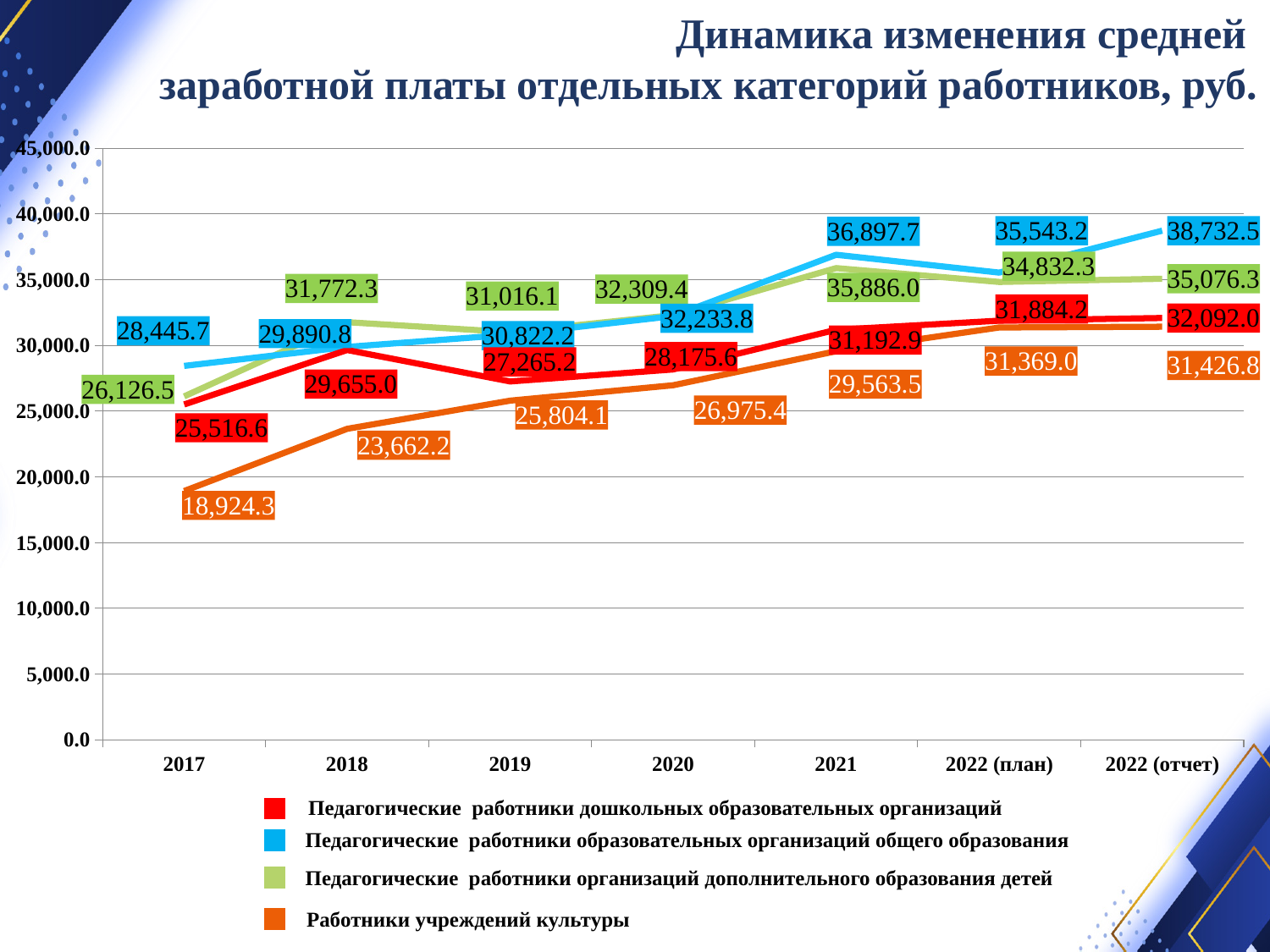
What is the difference between the 2022 (отчет) and 2017 values for Работники учреждений культуры? 12,502.5 Which is larger in 2018: the value for Педагогические работники организаций дополнительного образования детей or for Педагогические работники дошкольных образовательных организаций? Педагогические работники организаций дополнительного образования детей In which year is the value for Педагогические работники образовательных организаций общего образования highest? 2022 (отчет) What is the value for Педагогические работники образовательных организаций общего образования in 2022 (отчет)? 38,732.5 What is the value for Работники учреждений культуры in 2017? 18,924.3 Does the value for Работники учреждений культуры rise or fall from 2017 to 2022 (отчет)? rise What type of chart is shown on the slide? line chart In which year is the value for Работники учреждений культуры lowest? 2017 What is the value for Педагогические работники дошкольных образовательных организаций in 2019? 27,265.2 How many points along the x axis does the chart have? 7 How many series does the legend list? 4 What is the value for Педагогические работники организаций дополнительного образования детей in 2021? 35,886.0